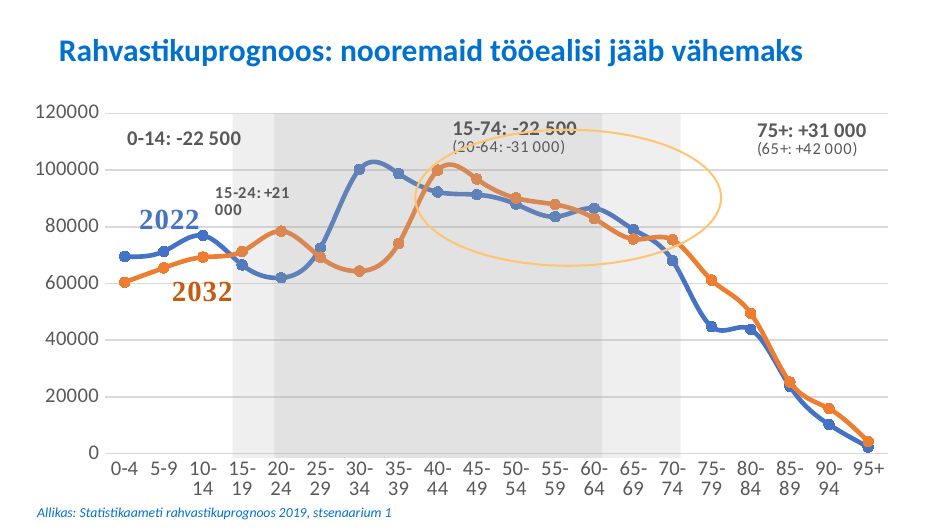
Do the values of both series rise or fall from the 70-74 age group to the 95+ age group? fall How many age-group categories are shown on the x axis? 20 Is the 2032 value for the 90-94 age group greater or less than 20000? less Which age group has the highest value for the 2032 series? 40-44 For the 30-34 age group, which series has the larger value, 2022 or 2032? 2022 Is the 2022 value for the 0-4 age group greater or less than 60000? greater Is the 2022 value for the 75-79 age group greater or less than 40000? greater What kind of chart is shown on the slide? line chart How many series are plotted on the chart? 2 For the 20-24 age group, which series has the larger value, 2022 or 2032? 2032 Which age group has the highest value for the 2022 series? 30-34 Which age group has the lowest value for the 2022 series? 95+